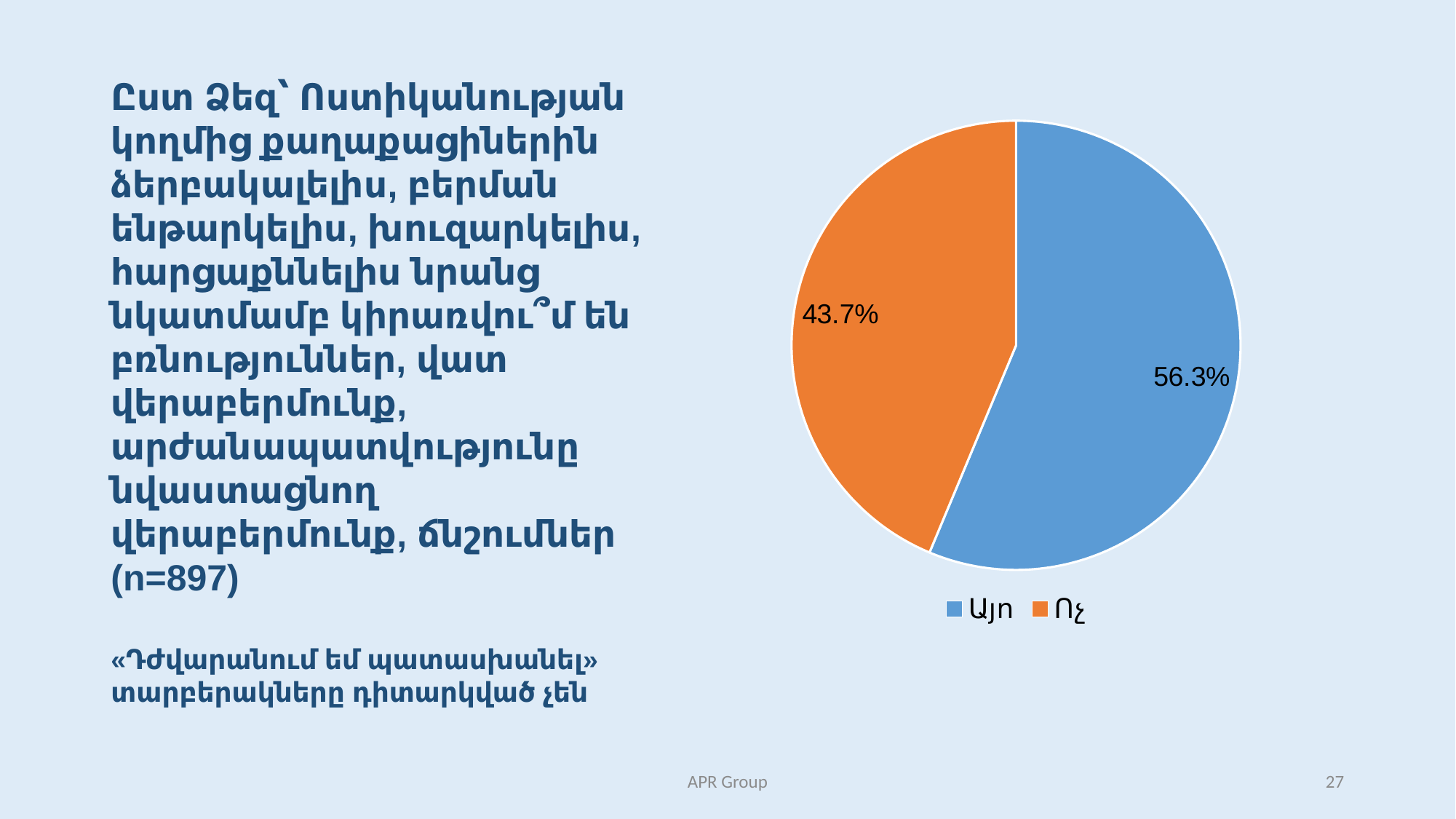
What is the difference between the Այո and Ոչ slices? 12.6% What colour is the Ոչ slice in the pie chart? orange How many entries does the legend list? 2 How many slices does the pie chart have? 2 Which is larger, the Այո slice or the Ոչ slice? Այո What kind of chart is shown on the slide? pie chart What is the value for Այո in the pie chart? 56.3% What is the value for Ոչ in the pie chart? 43.7% Which slice of the pie chart is the smallest? Ոչ Which slice of the pie chart is the largest? Այո What share of the pie does the Ոչ slice represent? 43.7% What colour is the Այո slice in the pie chart? blue